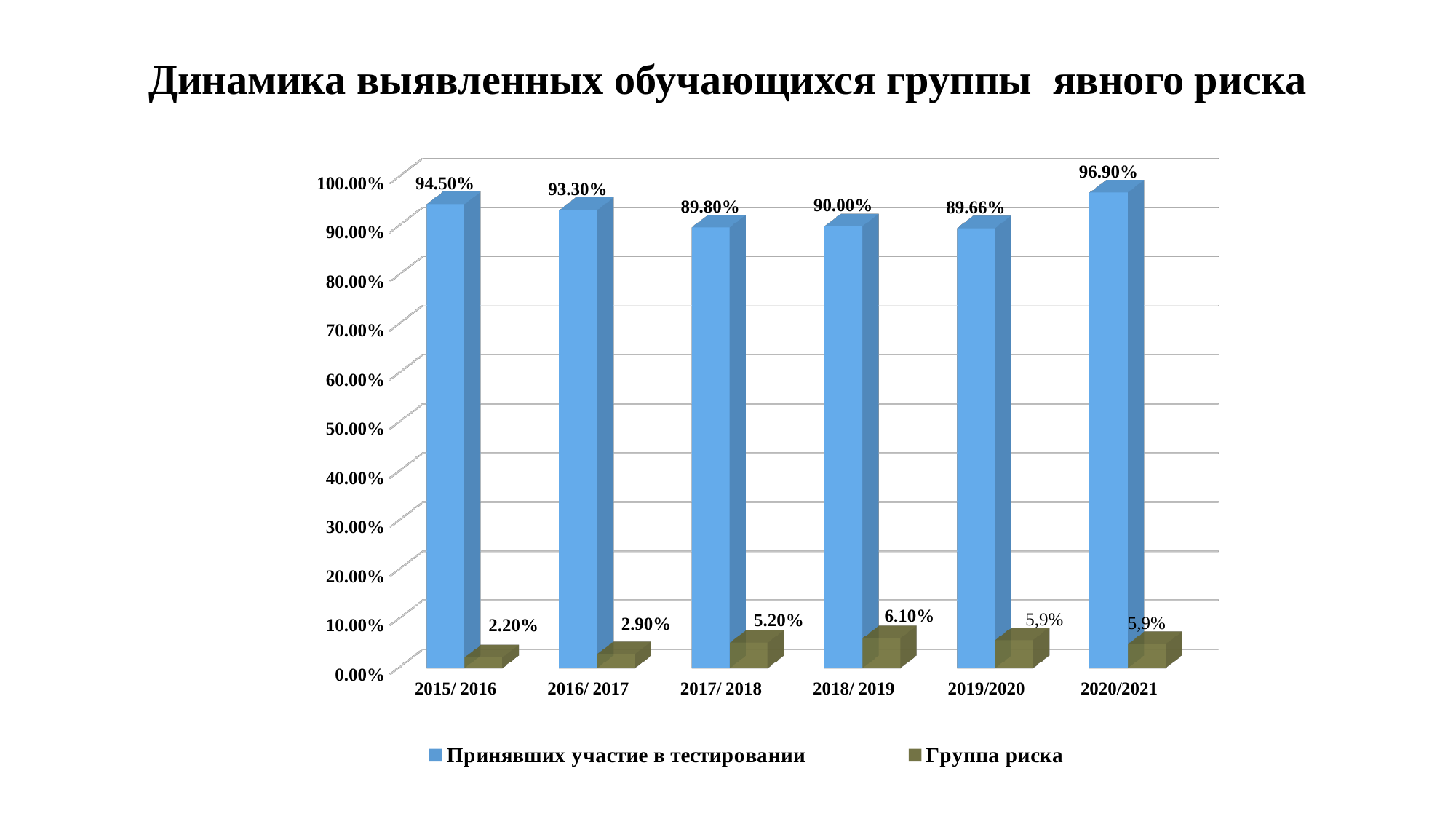
What is the value for 'Группа риска' in 2018/ 2019? 6.10% How many series does the legend list? 2 What is the value for 'Принявших участие в тестировании' in 2015/ 2016? 94.50% What kind of chart is shown on the slide? Bar chart In which year is the value for 'Группа риска' the lowest? 2015/ 2016 What is the difference between the 'Принявших участие в тестировании' values for 2015/ 2016 and 2016/ 2017? 1.20% Which is larger: the 'Группа риска' value for 2017/ 2018 or for 2016/ 2017? 2017/ 2018 How many academic years (categories) are shown on the x axis? 6 Does the 'Группа риска' value rise or fall from 2015/ 2016 to 2018/ 2019? Rise What is the value for 'Группа риска' in 2020/2021? 5,9% In which year is the value for 'Принявших участие в тестировании' the highest? 2020/2021 What is the value for 'Принявших участие в тестировании' in 2019/2020? 89.66%